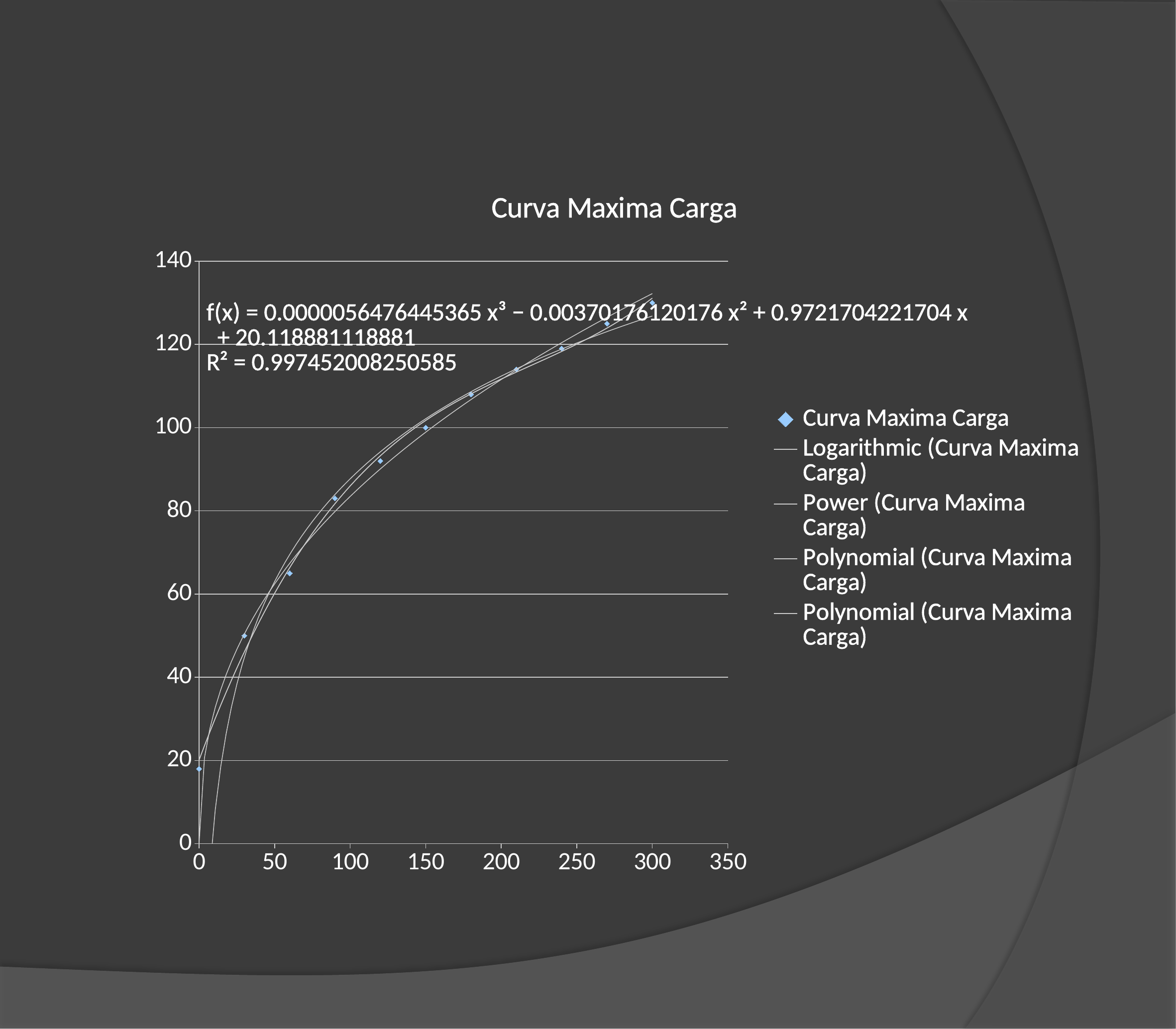
Is the plotted value at x = 0 greater or less than 20? less How many data points are plotted for the Curva Maxima Carga series? 11 At which x value is the plotted value highest? 300 Do the plotted values rise or fall as x increases along the x axis? rise What is the title of the chart? Curva Maxima Carga Is the plotted value at x = 300 greater or less than 120? greater What R² value is printed on the chart? 0.997452008250585 Is the plotted value at x = 120 greater or less than 100? less Which has the larger plotted value, x = 180 or x = 60? x = 180 At which x value is the plotted value lowest? 0 What kind of chart is shown on the slide? scatter chart How many entries does the chart legend list? 5